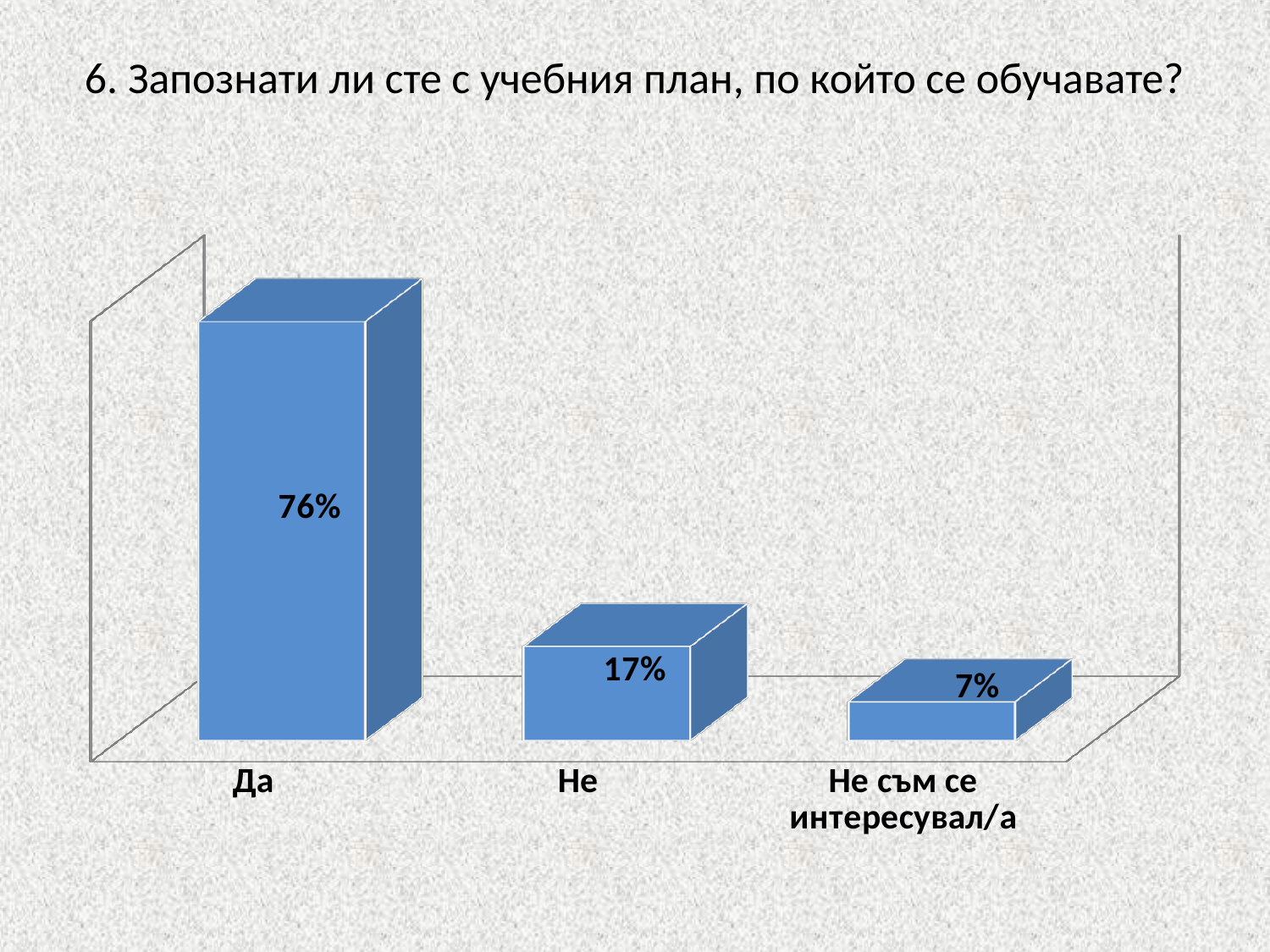
What is the value for "Не съм се интересувал/а"? 7% How many categories are shown in the chart? 3 What is the difference between the values for "Не" and "Не съм се интересувал/а"? 10% Which is larger, the value for "Не" or the value for "Не съм се интересувал/а"? Не What is the difference between the values for "Да" and "Не"? 59% What kind of chart is shown on the slide? Bar chart Which category has the lowest value? Не съм се интересувал/а What is the value for "Не"? 17% What is the value for "Да"? 76% What is the title of the chart? 6. Запознати ли сте с учебния план, по който се обучавате? Which category has the highest value? Да Do the values rise or fall from left to right along the x axis? Fall